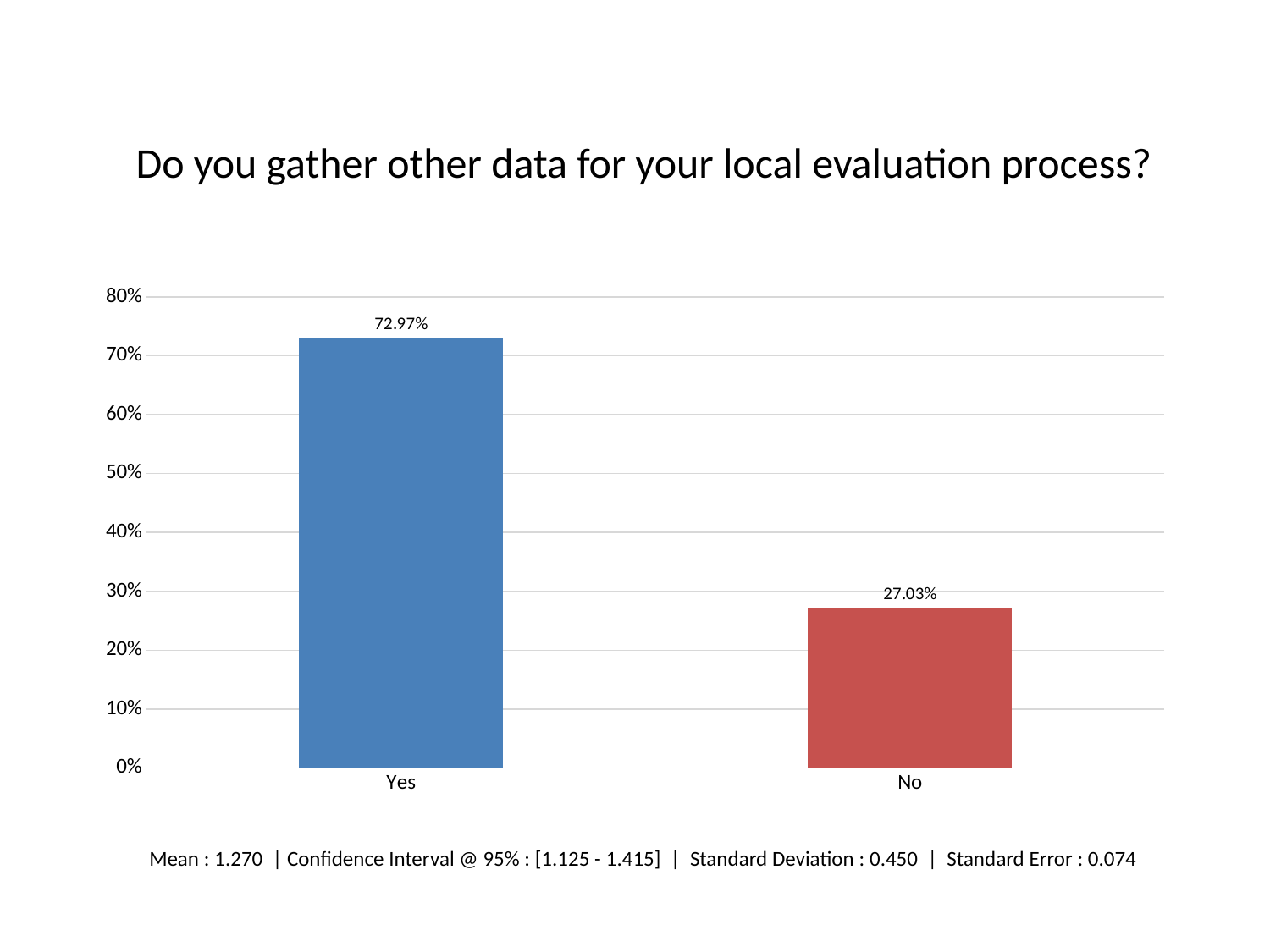
What is the title of the chart? Do you gather other data for your local evaluation process? Which is larger, the value for Yes or the value for No? Yes What kind of chart is shown on the slide? bar chart Which category has the lowest value? No Is the value for No greater or less than 30%? less What colour is the bar for No? red Which category has the highest value? Yes What is the difference in percentage points between the Yes and No values? 45.94 Is the value for Yes greater or less than 70%? greater How many categories are shown on the x axis? 2 What percentage of respondents answered Yes? 72.97% What percentage of respondents answered No? 27.03%